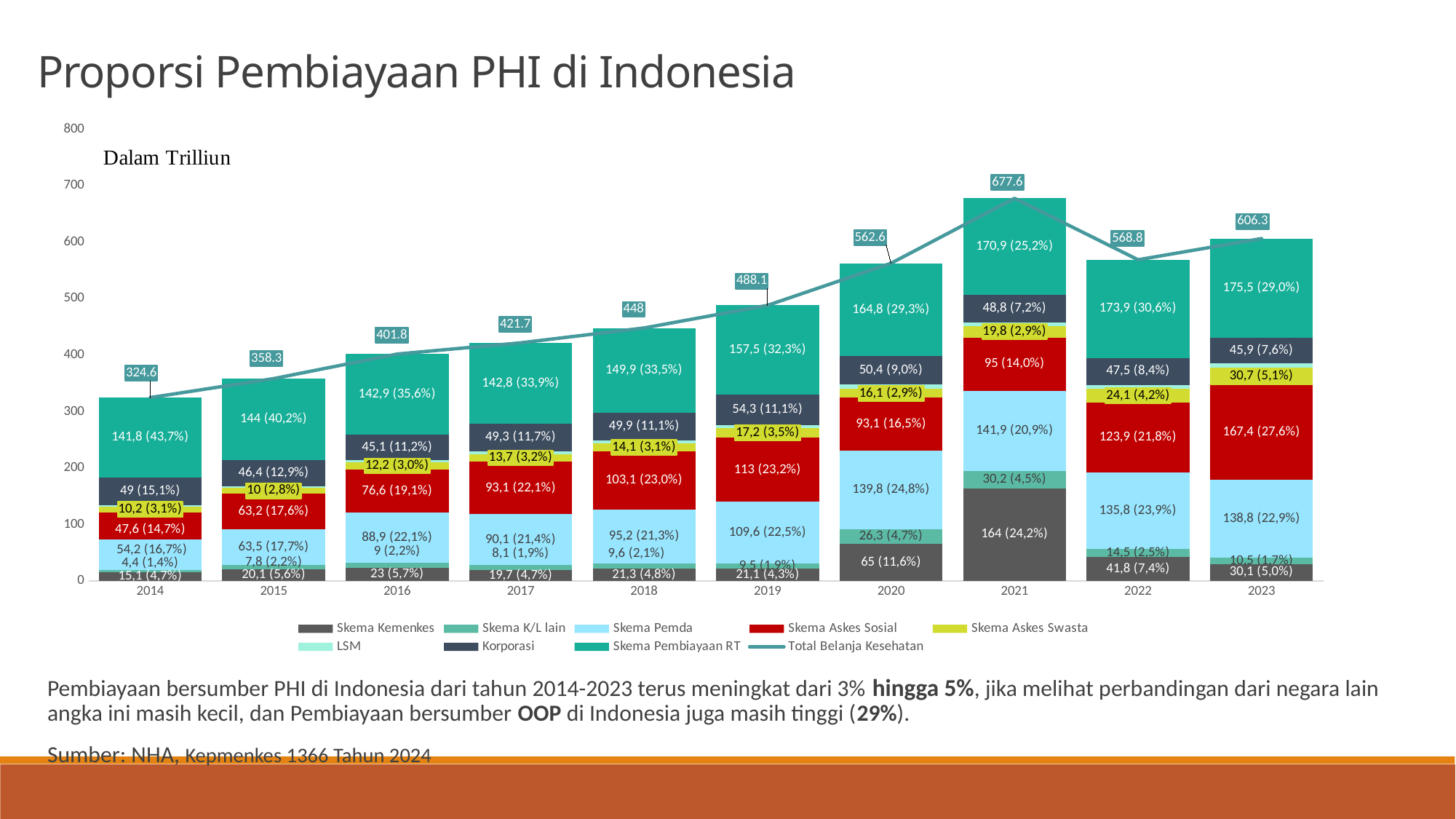
What is the label for Skema Pembiayaan RT in 2023? 175,5 (29,0%) What is the difference between Total Belanja Kesehatan in 2021 and 2022? 108.8 In which year is Total Belanja Kesehatan lowest? 2014 What unit is stated in the text at the top left of the chart? Dalam Trilliun Which is larger, Skema Pemda in 2020 or Skema Pemda in 2023? Skema Pemda in 2020 What is the label for Skema Askes Sosial in 2018? 103,1 (23,0%) What is the label for Skema Kemenkes in 2021? 164 (24,2%) How many years are shown on the x axis? 10 How many series does the legend list? 9 In which year is Total Belanja Kesehatan highest? 2021 What kind of chart is shown on the slide? Stacked bar chart with a line What is the Total Belanja Kesehatan value for 2021? 677.6